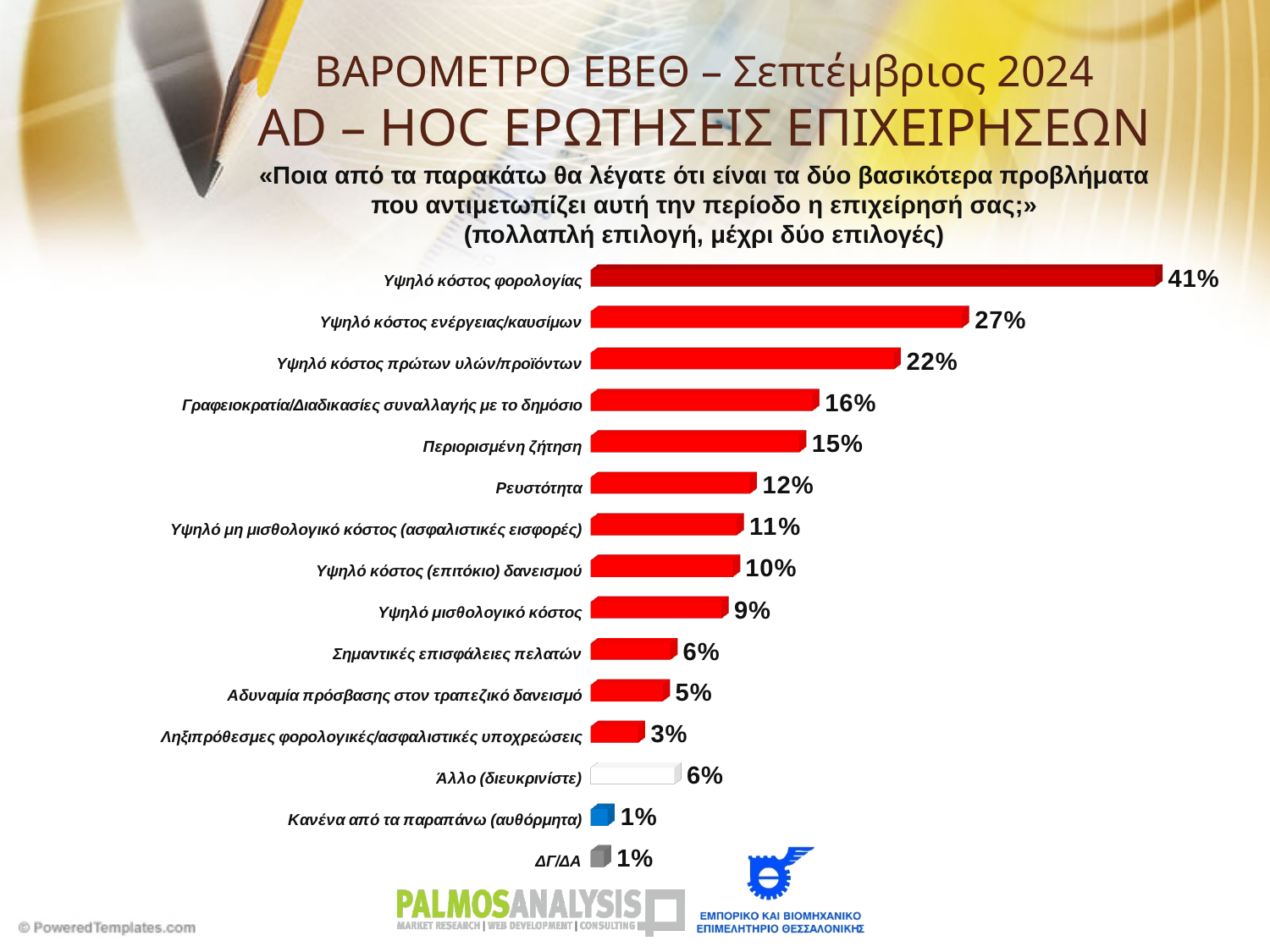
What is the value for Υψηλό κόστος ενέργειας/καυσίμων? 27% Which is larger, the value for Γραφειοκρατία/Διαδικασίες συναλλαγής με το δημόσιο or the value for Υψηλό μισθολογικό κόστος? Γραφειοκρατία/Διαδικασίες συναλλαγής με το δημόσιο What is the difference between the values for Υψηλό κόστος πρώτων υλών/προϊόντων and Περιορισμένη ζήτηση? 7% What kind of chart is shown on the slide? Bar chart What is the value for Ρευστότητα? 12% What is the value for Αδυναμία πρόσβασης στον τραπεζικό δανεισμό? 5% Which category has the highest value? Υψηλό κόστος φορολογίας What is the value for Ληξιπρόθεσμες φορολογικές/ασφαλιστικές υποχρεώσεις? 3% What is the value for Υψηλό κόστος φορολογίας? 41% What is the value for ΔΓ/ΔΑ? 1% How many categories are shown in the chart? 15 What is the difference between the values for Υψηλό κόστος φορολογίας and Υψηλό κόστος ενέργειας/καυσίμων? 14%